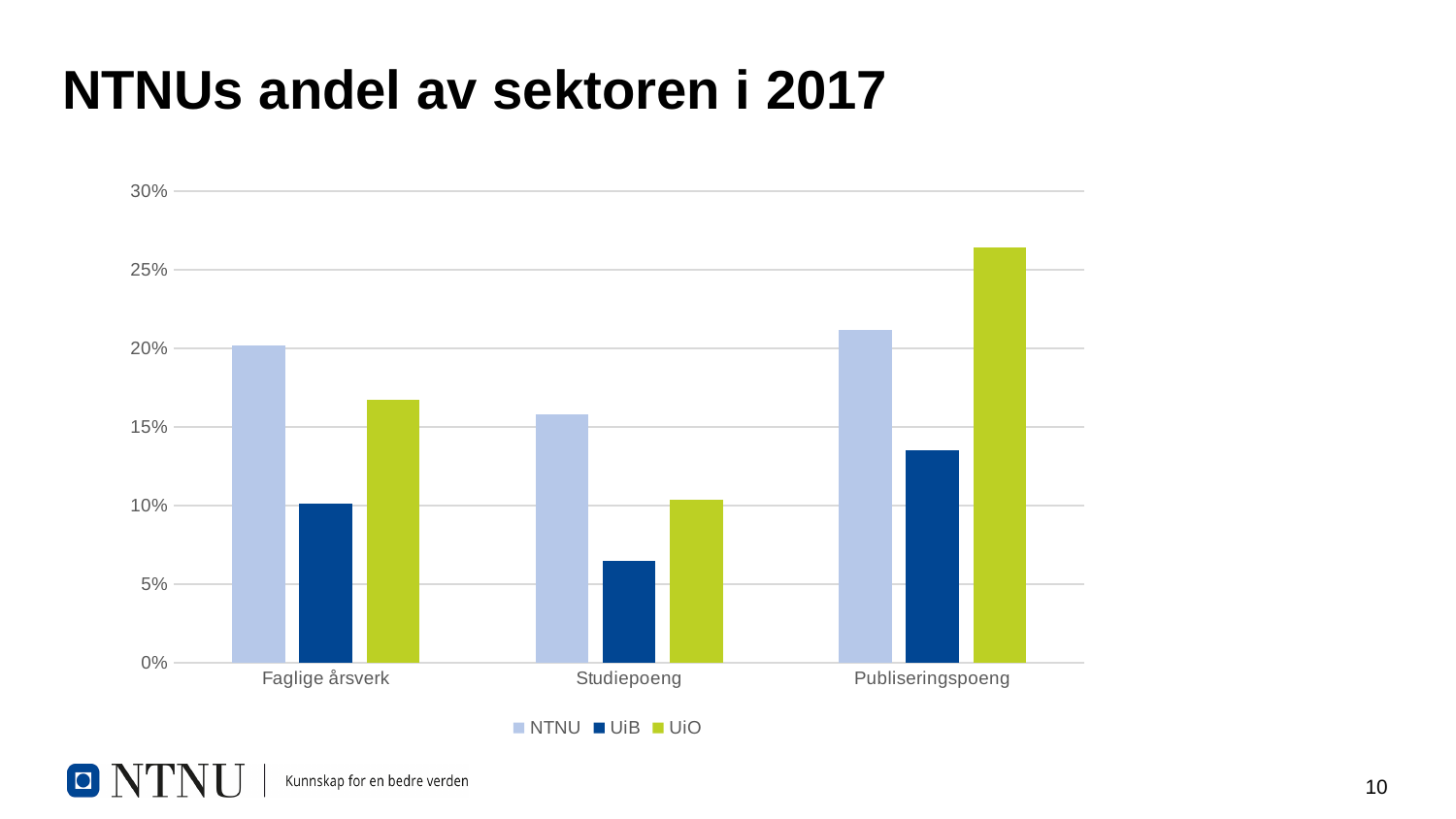
Which series has the lowest value for Studiepoeng? UiB Which is larger: NTNU's value for Studiepoeng or UiO's value for Studiepoeng? NTNU's value for Studiepoeng Which series has the highest value for Faglige årsverk? NTNU Is the value for UiB in Publiseringspoeng greater or less than 15%? less Is the value for UiO in Publiseringspoeng greater or less than 25%? greater Which series has the highest value for Publiseringspoeng? UiO Is the value for NTNU in Publiseringspoeng greater or less than 20%? greater What kind of chart is shown on the slide? bar chart How many categories are shown on the x axis? 3 How many series does the legend list? 3 What is the title of the chart on the slide? NTNUs andel av sektoren i 2017